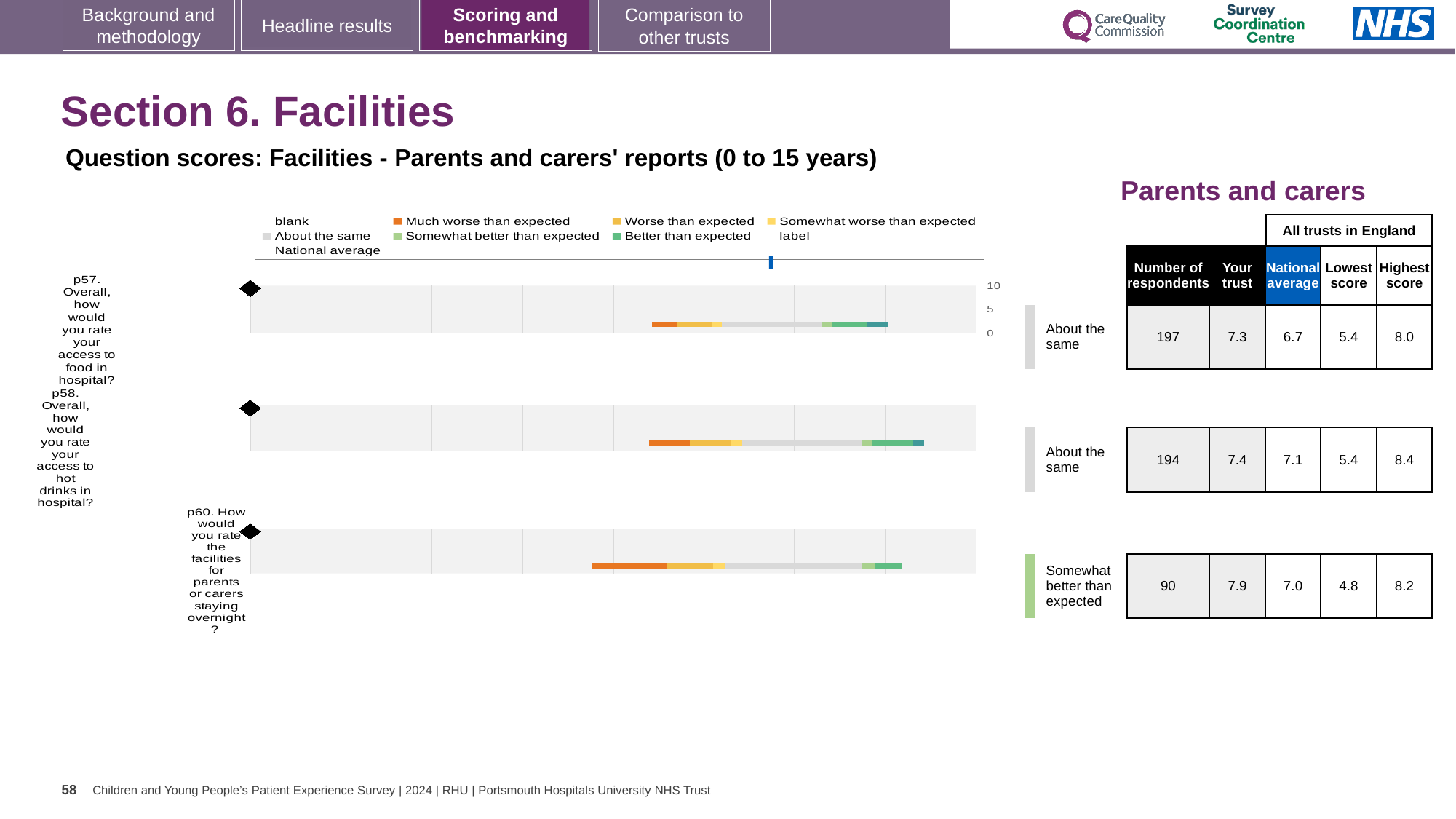
In the table beside the charts, what is the 'Your trust' score for p57 (access to food in hospital)? 7.3 In the table, what is the Lowest score among all trusts in England for p60? 4.8 What colour does the legend use for 'Much worse than expected'? Orange For p57, which is larger in the table: the 'Your trust' score or the National average? Your trust What benchmark category label is shown next to the chart for p60? Somewhat better than expected In the table, what is the Highest score among all trusts in England for p58? 8.4 For p60, how much higher is the 'Your trust' score than the National average in the table? 0.9 How many survey questions are plotted as charts on this slide? 3 Which of the three questions has the highest 'Your trust' score in the table? p60 What kind of chart is used to show the question scores for p57, p58 and p60? Bar chart In the table beside the charts, how many respondents answered p60 (facilities for parents or carers staying overnight)? 90 In the table beside the charts, what is the National average score for p58 (access to hot drinks in hospital)? 7.1